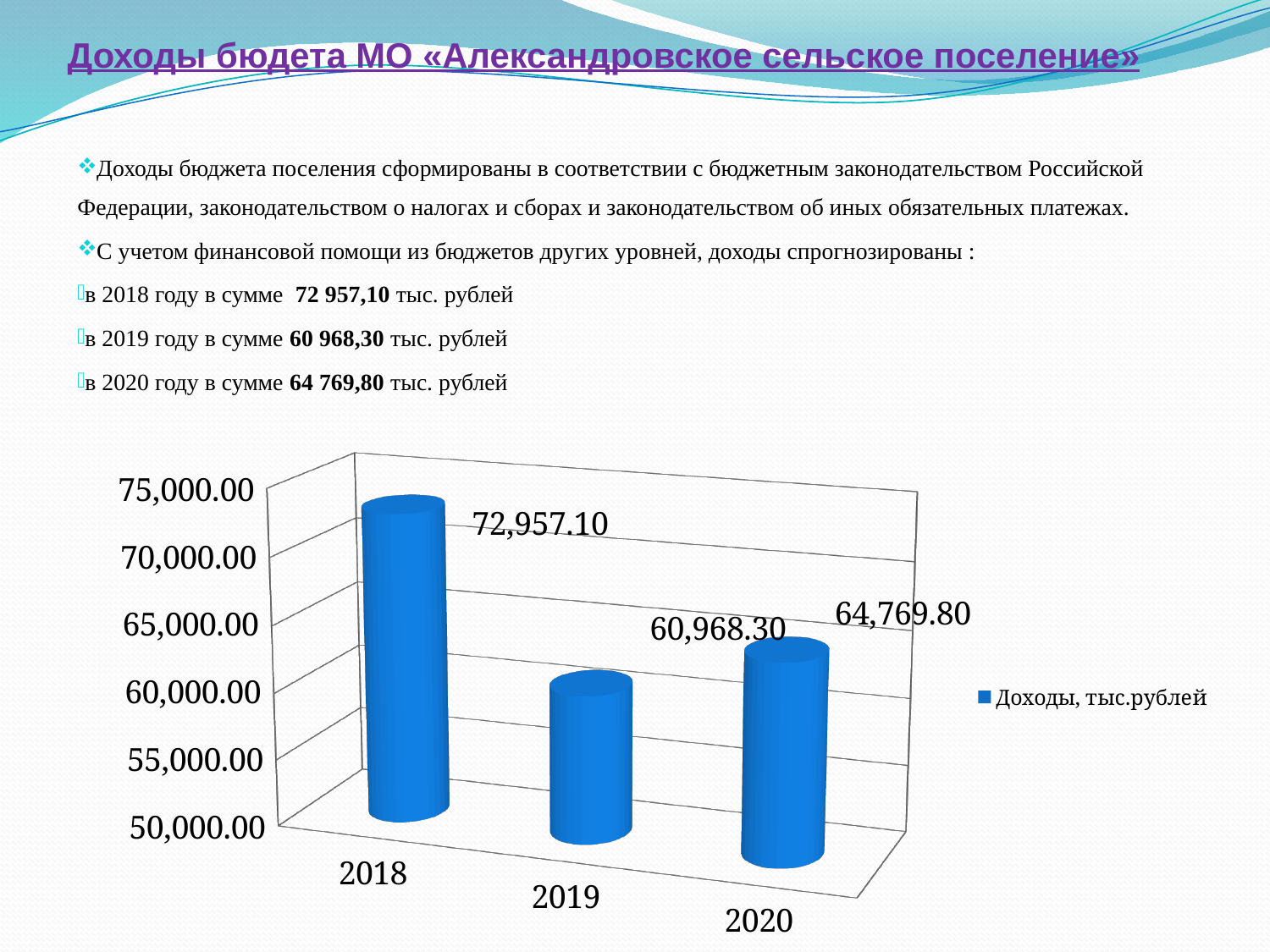
What is the value for 2019? 60,968.30 What is the value for 2020? 64,769.80 What is the value for 2018? 72,957.10 What is the difference between the values for 2020 and 2019? 3,801.50 Which year has the highest value? 2018 What is the difference between the values for 2018 and 2019? 11,988.80 How many years are shown on the x axis? 3 What is the legend entry of the chart? Доходы, тыс.рублей What kind of chart is shown on the slide? bar chart Which is larger, the value for 2019 or the value for 2020? 2020 Which year has the lowest value? 2019 Is the value for 2019 greater or less than 65,000.00? less